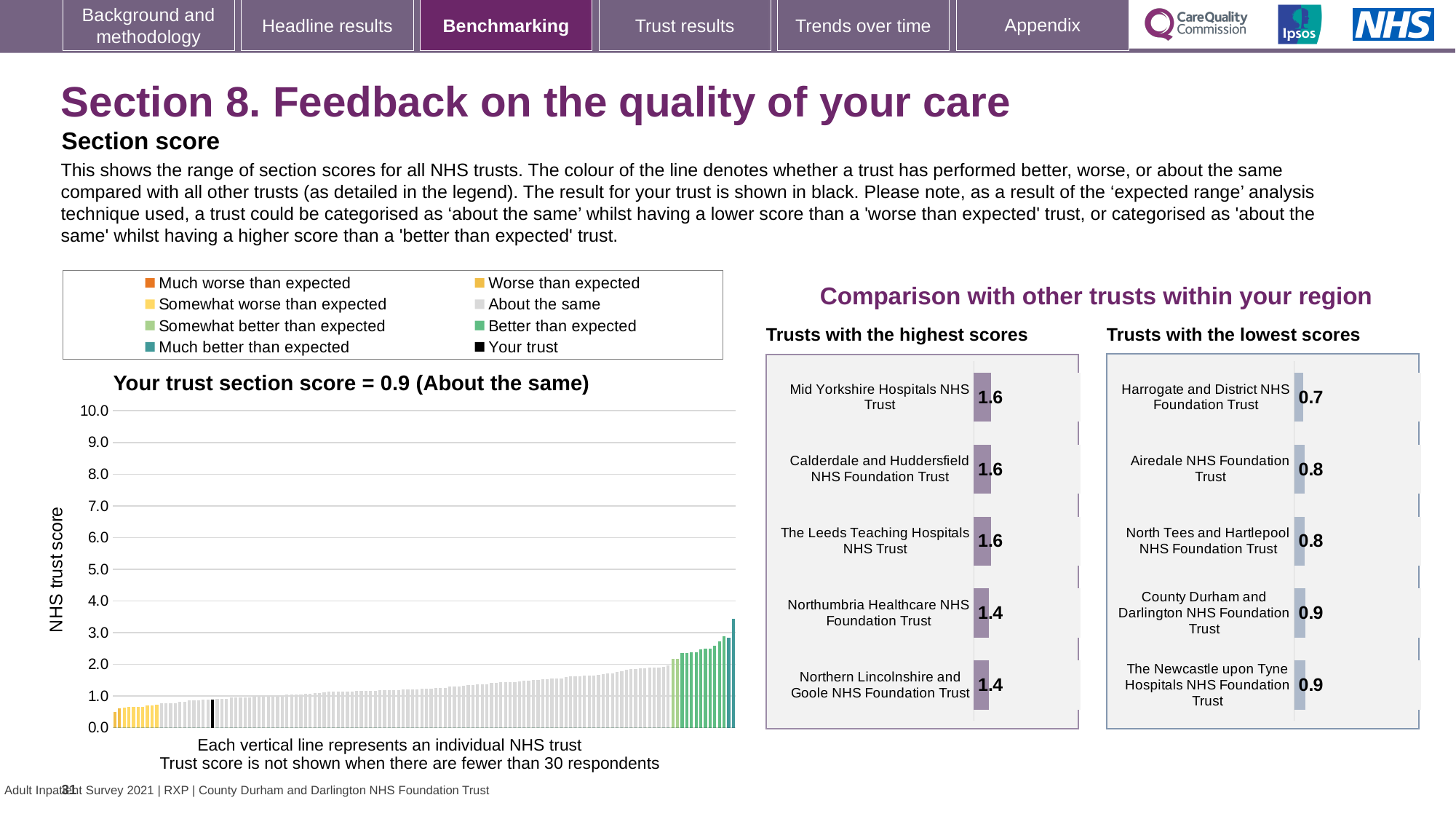
In the 'Your trust section score' chart, what is the section score for your trust? 0.9 How many entries does the legend above the 'Your trust section score' chart list? 8 In the 'Trusts with the lowest scores' chart, which trust has the lowest score? Harrogate and District NHS Foundation Trust In the 'Trusts with the highest scores' chart, what is the difference between the score for Mid Yorkshire Hospitals NHS Trust and the score for Northern Lincolnshire and Goole NHS Foundation Trust? 0.2 In the 'Trusts with the highest scores' chart, what is the score for Mid Yorkshire Hospitals NHS Trust? 1.6 In the 'Trusts with the lowest scores' chart, which has the larger score: Airedale NHS Foundation Trust or County Durham and Darlington NHS Foundation Trust? County Durham and Darlington NHS Foundation Trust In the 'Trusts with the lowest scores' chart, what is the difference between the score for The Newcastle upon Tyne Hospitals NHS Foundation Trust and the score for Harrogate and District NHS Foundation Trust? 0.2 In the 'Trusts with the lowest scores' chart, what is the score for Harrogate and District NHS Foundation Trust? 0.7 How many trusts are listed in the 'Trusts with the highest scores' chart? 5 What kind of chart is the 'Your trust section score' chart on the left? Bar chart In the 'Trusts with the highest scores' chart, what is the score for Northumbria Healthcare NHS Foundation Trust? 1.4 In the 'Your trust section score' chart, is the value of the tallest bar greater or less than 3.0? greater